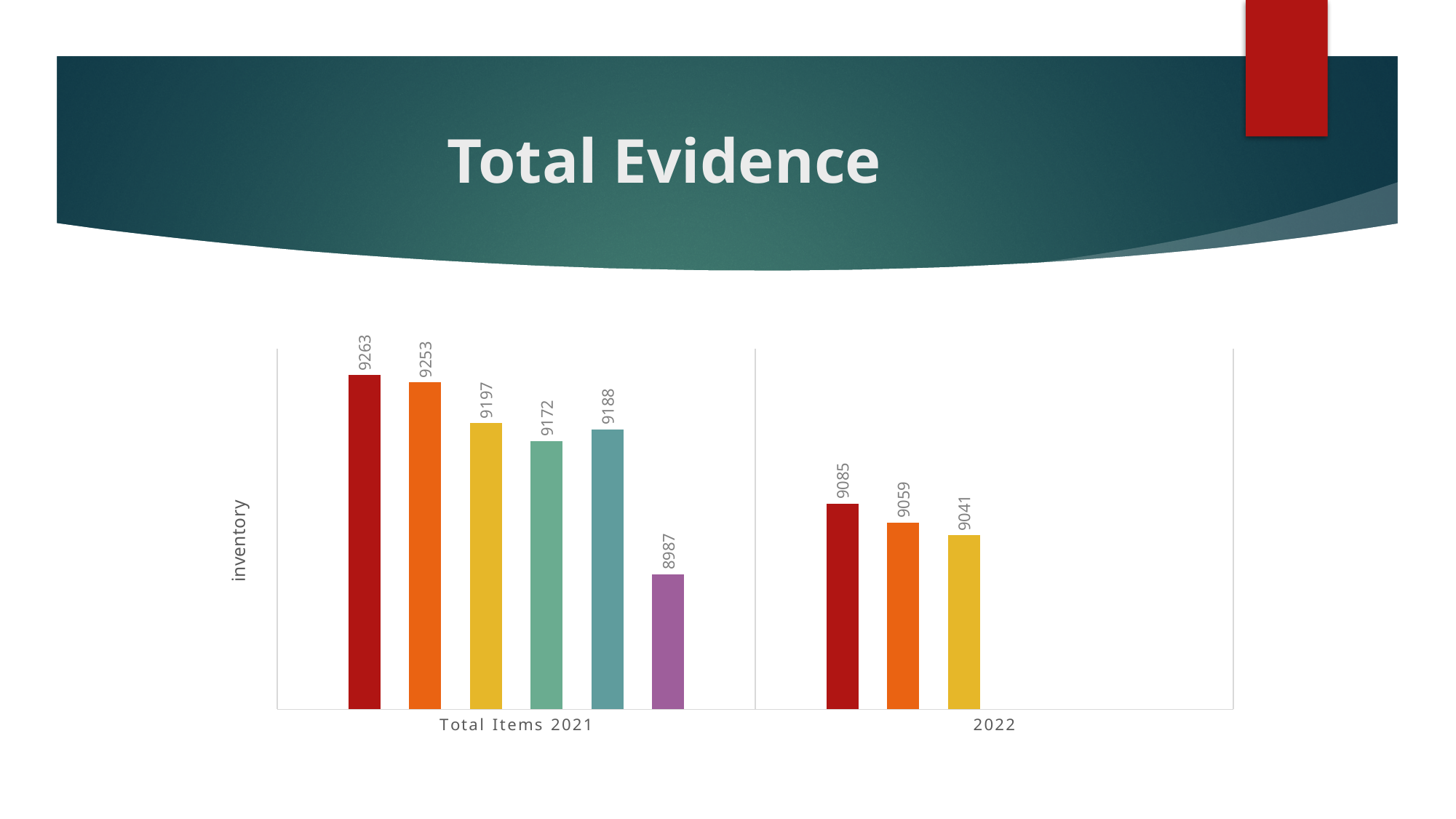
What is the title of the slide containing the chart? Total Evidence Which is larger: the orange bar in Total Items 2021 or the orange bar in 2022? the orange bar in Total Items 2021 What is the value of the first (red) bar in the 2022 group? 9085 What is the value of the third (yellow) bar in the 2022 group? 9041 Which bar has the highest value in the chart? the first (red) bar in Total Items 2021, 9263 What is the difference between the red bar in Total Items 2021 (9263) and the red bar in 2022 (9085)? 178 What kind of chart is shown on the slide? bar chart Which bar has the lowest value in the chart? the last (purple) bar in Total Items 2021, 8987 What is the value of the first (red) bar in the Total Items 2021 group? 9263 What is the label on the vertical axis of the chart? inventory What is the value of the last (purple) bar in the Total Items 2021 group? 8987 How many categories are shown on the x axis of the chart? 2